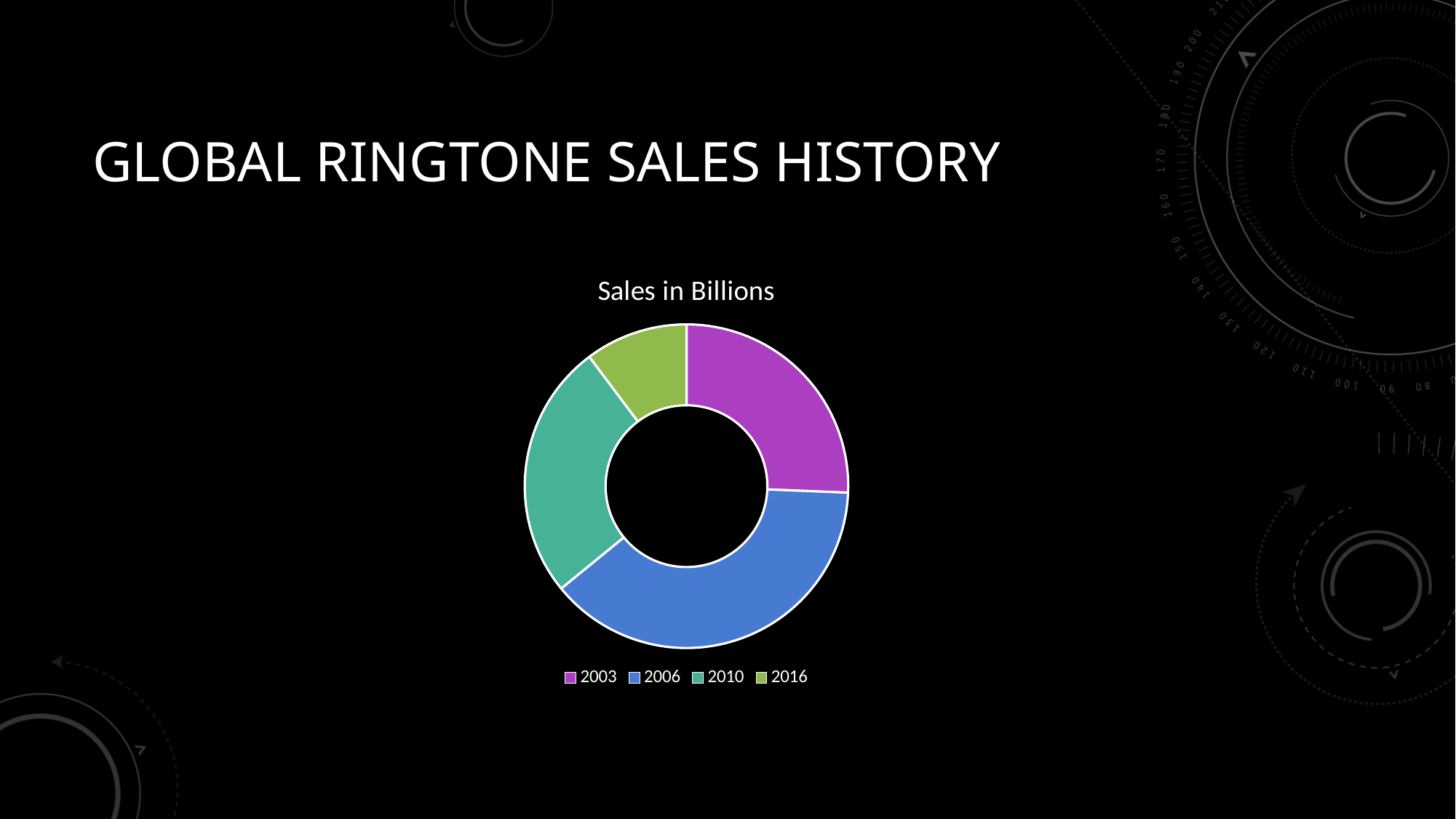
What kind of chart is shown on the slide? Doughnut chart What is the title of the chart? Sales in Billions Which has the larger share, 2006 or 2003? 2006 Which year is represented by the purple segment? 2003 Which has the larger share, 2003 or 2016? 2003 How many categories does the chart show? 4 Which has the larger share, 2006 or 2016? 2006 Which year has the largest share of the doughnut chart? 2006 How many entries does the chart's legend list? 4 Which year has the smallest share of the doughnut chart? 2016